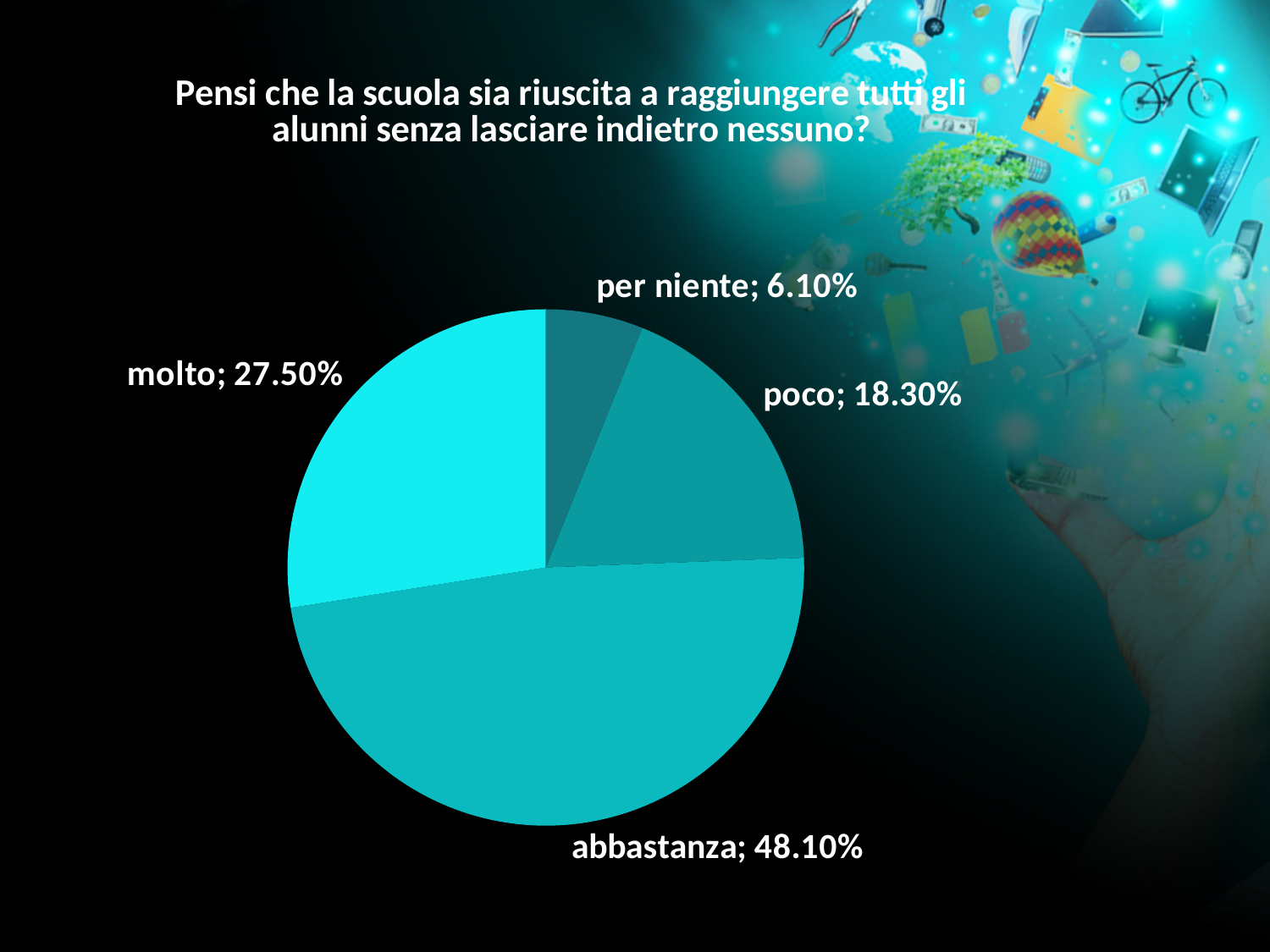
What is the value for "abbastanza"? 48.10% What is the value for "molto"? 27.50% Which category has the smallest share of the pie? per niente What question is shown as the title above the chart? Pensi che la scuola sia riuscita a raggiungere tutti gli alunni senza lasciare indietro nessuno? Which category has the largest share of the pie? abbastanza What kind of chart is shown on the slide? pie chart What is the difference between the values for "poco" and "per niente"? 12.20% Which is larger, the value for "poco" or the value for "molto"? molto What is the value for "per niente"? 6.10% What is the value for "poco"? 18.30% What is the difference between the values for "abbastanza" and "molto"? 20.60% How many slices does the pie chart have? 4